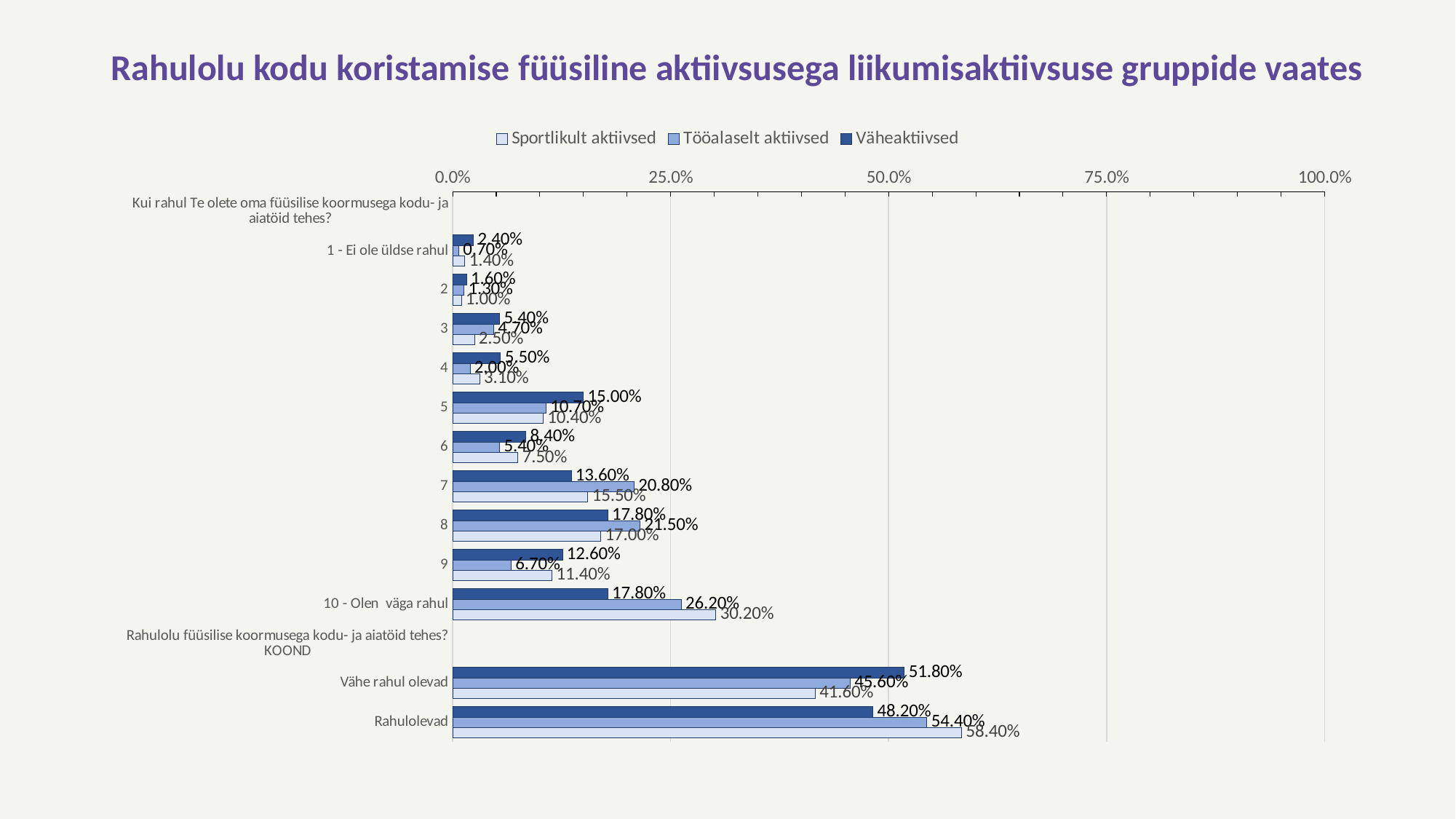
What is the title of the chart? Rahulolu kodu koristamise füüsiline aktiivsusega liikumisaktiivsuse gruppide vaates What is the value for Väheaktiivsed in the Vähe rahul olevad category? 51.80% What is the value for Tööalaselt aktiivsed in the '10 - Olen väga rahul' category? 26.20% Is the value for Sportlikult aktiivsed in the Rahulolevad category greater or less than 50.0%? greater Which series has the lowest value in the Vähe rahul olevad category? Sportlikult aktiivsed Which series has the highest value in the Rahulolevad category? Sportlikult aktiivsed How many series does the legend list? 3 What kind of chart is shown on the slide? bar chart What is the value for Väheaktiivsed in category 5? 15.00% What is the value for Sportlikult aktiivsed in the Rahulolevad category? 58.40% What is the difference between Sportlikult aktiivsed and Väheaktiivsed in the Rahulolevad category? 10.20 percentage points In category 7, which is larger: Tööalaselt aktiivsed or Väheaktiivsed? Tööalaselt aktiivsed